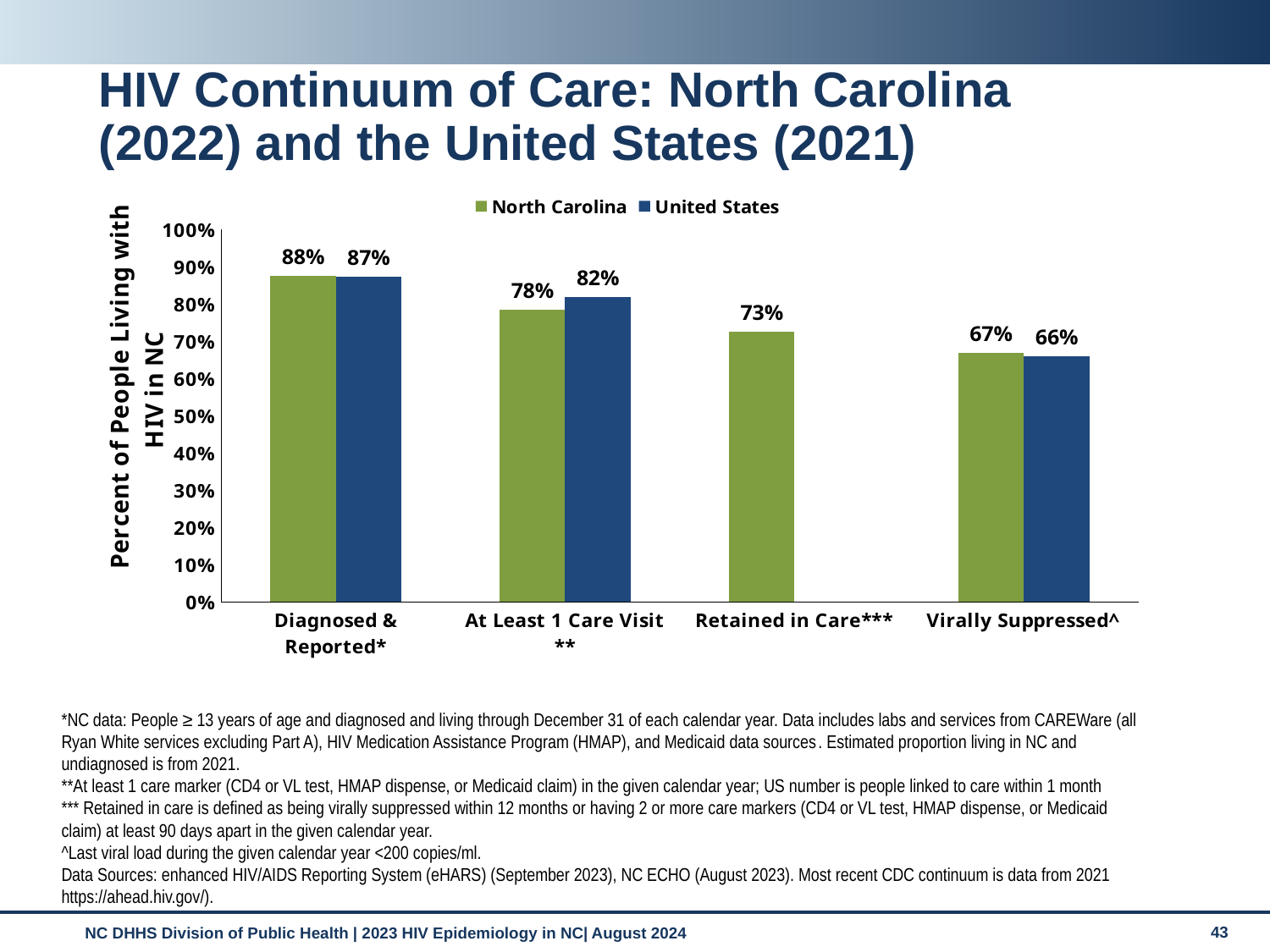
How many series does the legend list? 2 What is the North Carolina value for Diagnosed & Reported*? 88% Do the North Carolina values rise or fall from left to right along the x axis? Fall What kind of chart is shown on the slide? Bar chart What is the North Carolina value for Retained in Care***? 73% What is the United States value for Virally Suppressed^? 66% Which category has the lowest United States value? Virally Suppressed^ How many categories are shown on the x axis? 4 Which is larger for Virally Suppressed^: North Carolina or United States? North Carolina What is the United States value for At Least 1 Care Visit**? 82% Which category has the highest North Carolina value? Diagnosed & Reported* What is the difference between the United States and North Carolina values for At Least 1 Care Visit**? 4%